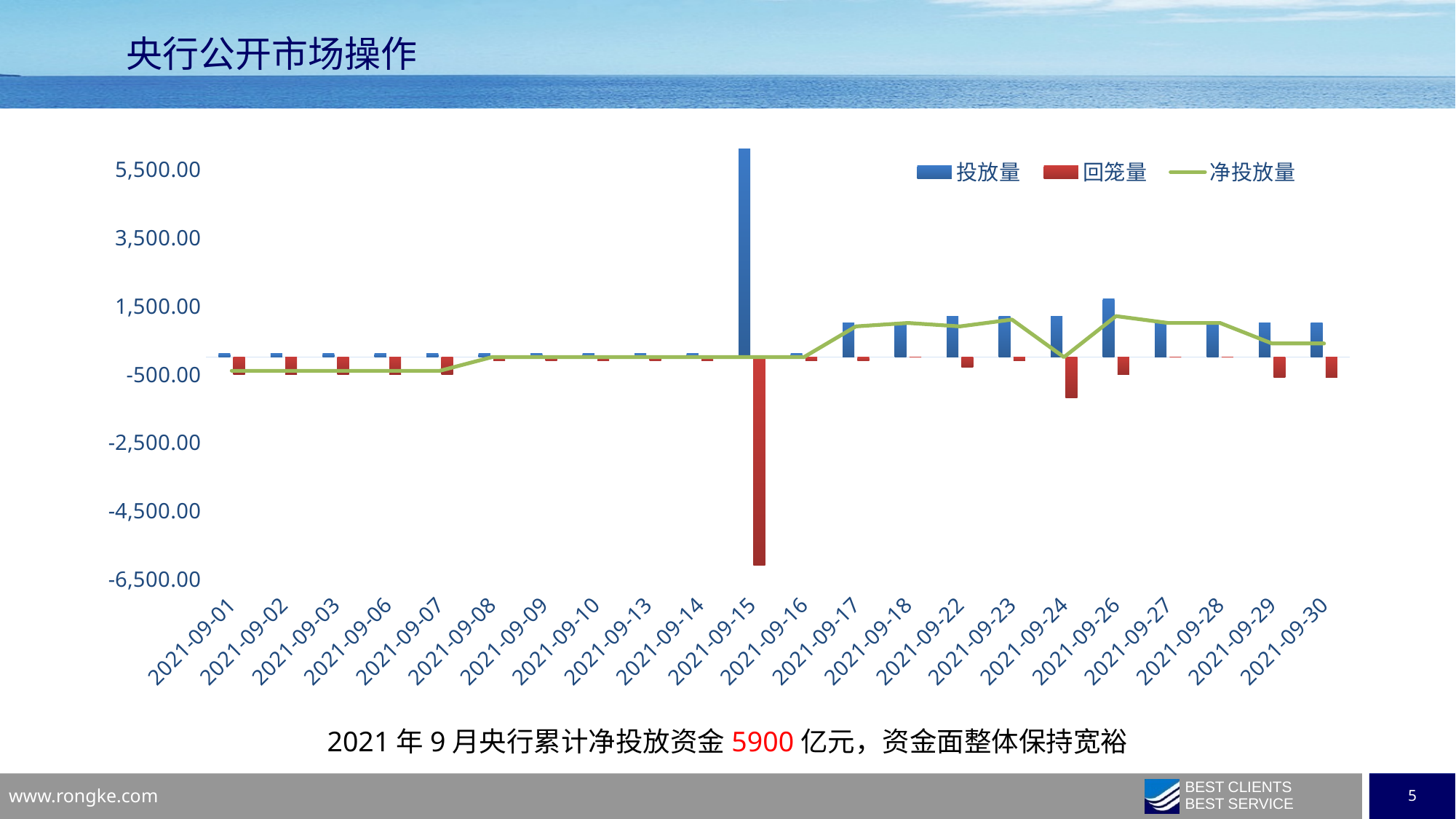
What kind of chart is shown on the slide? A combined bar and line chart What is the title of the slide containing the chart? 央行公开市场操作 On which date does the 回笼量 bar reach its lowest (most negative) value? 2021-09-15 How many dates are shown on the x axis of the chart? 22 Which series in the chart is drawn as a green line? 净投放量 Which date has the larger 投放量 bar, 2021-09-26 or 2021-09-17? 2021-09-26 Does the 净投放量 line rise or fall from 2021-09-16 to 2021-09-17? rise Is the 投放量 value for 2021-09-15 greater or less than 3,500.00? greater On which date is the 投放量 bar the highest? 2021-09-15 Is the 投放量 value for 2021-09-17 greater or less than 1,500.00? less How many series does the chart legend list? 3 Is the 回笼量 value for 2021-09-15 greater or less than -4,500.00? less